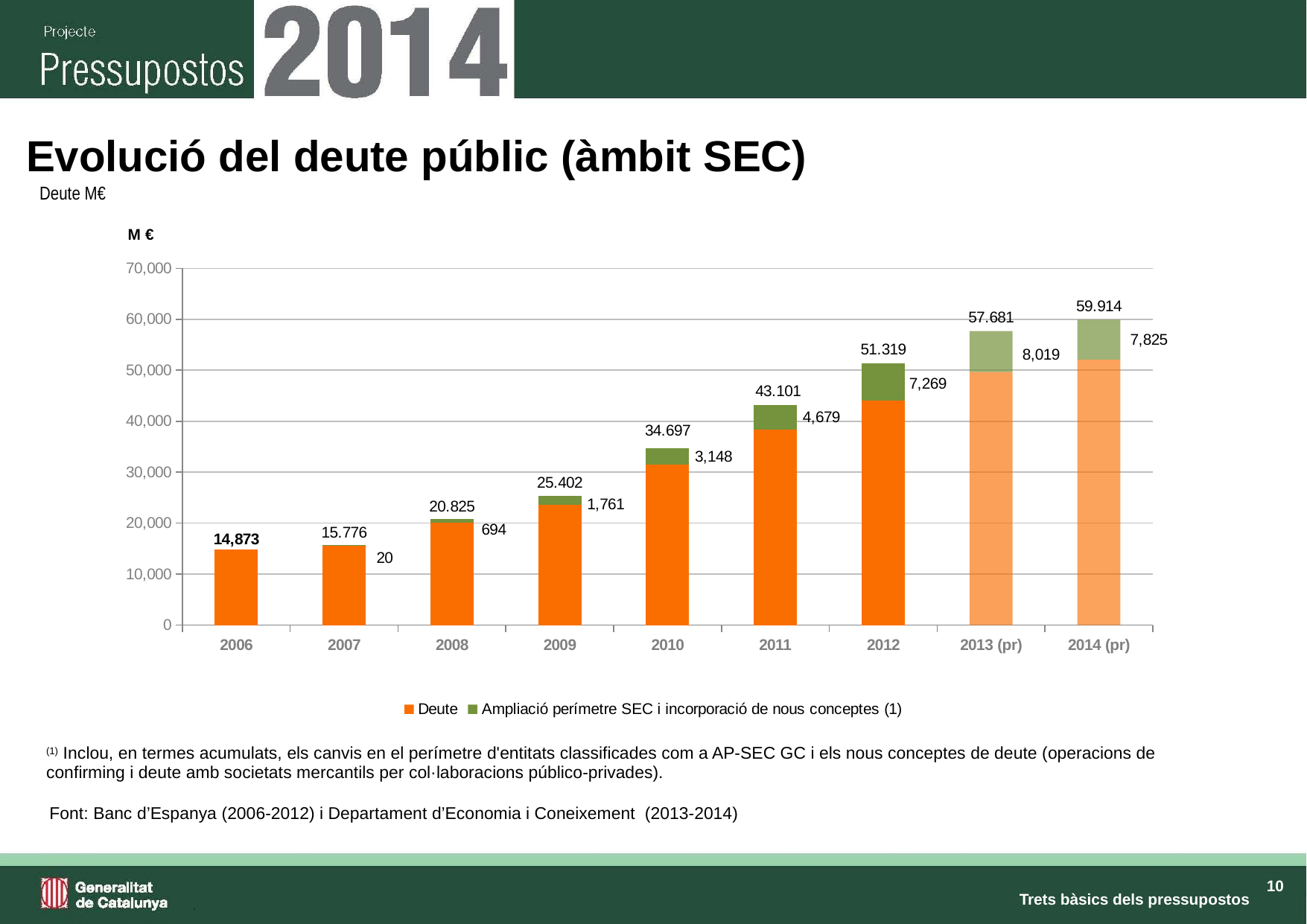
Which year has the lowest total public debt? 2006 Is the total public debt for 2010 greater or less than 30,000? greater What kind of chart is shown on the slide? Stacked bar chart What is the total public debt shown for 2012? 51.319 How many series does the legend list? 2 What is the total public debt shown for 2014 (pr)? 59.914 Which year has the highest total public debt? 2014 (pr) How many years are shown on the x axis? 9 What is the difference between the 'Ampliació perímetre SEC' segment for 2013 (pr) and for 2014 (pr)? 194 Which is larger, the 'Ampliació perímetre SEC' segment for 2012 or for 2011? 2012 What is the value of the 'Ampliació perímetre SEC i incorporació de nous conceptes (1)' segment for 2011? 4,679 What is the value of the green segment for 2007? 20